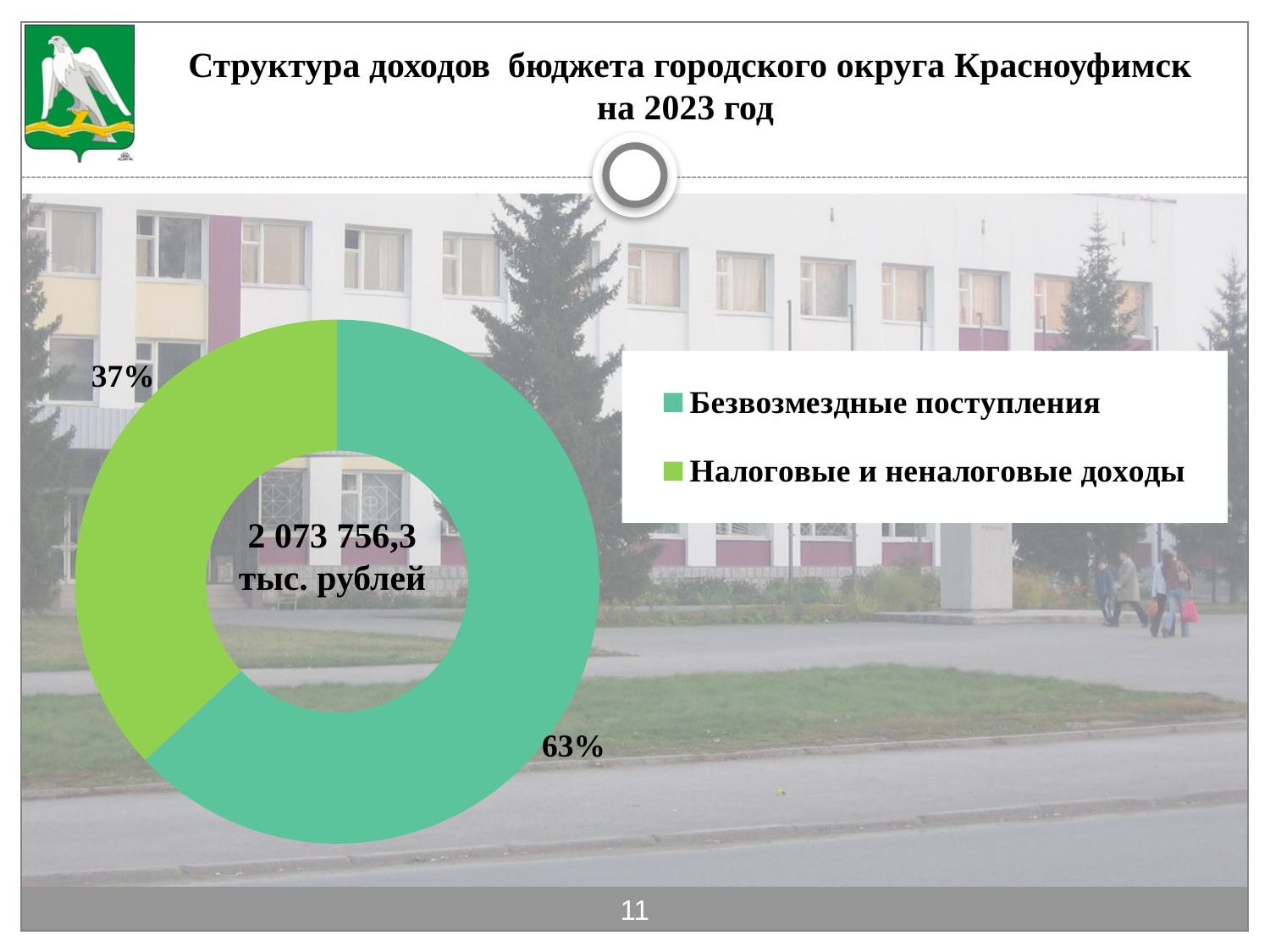
What share of the budget revenue is Безвозмездные поступления? 63% What share of the budget revenue is Налоговые и неналоговые доходы? 37% By how many percentage points does Безвозмездные поступления exceed Налоговые и неналоговые доходы? 26 percentage points Which is larger: Безвозмездные поступления or Налоговые и неналоговые доходы? Безвозмездные поступления How many entries does the legend list? 2 Which category has the smallest share of the chart? Налоговые и неналоговые доходы How many categories does the chart show? 2 What total amount is printed in the centre of the chart? 2 073 756,3 тыс. рублей What is the title of the slide? Структура доходов бюджета городского округа Красноуфимск на 2023 год Which legend entry is shown in light green? Налоговые и неналоговые доходы Which category has the largest share of the chart? Безвозмездные поступления What kind of chart is shown on the slide? Doughnut (pie) chart